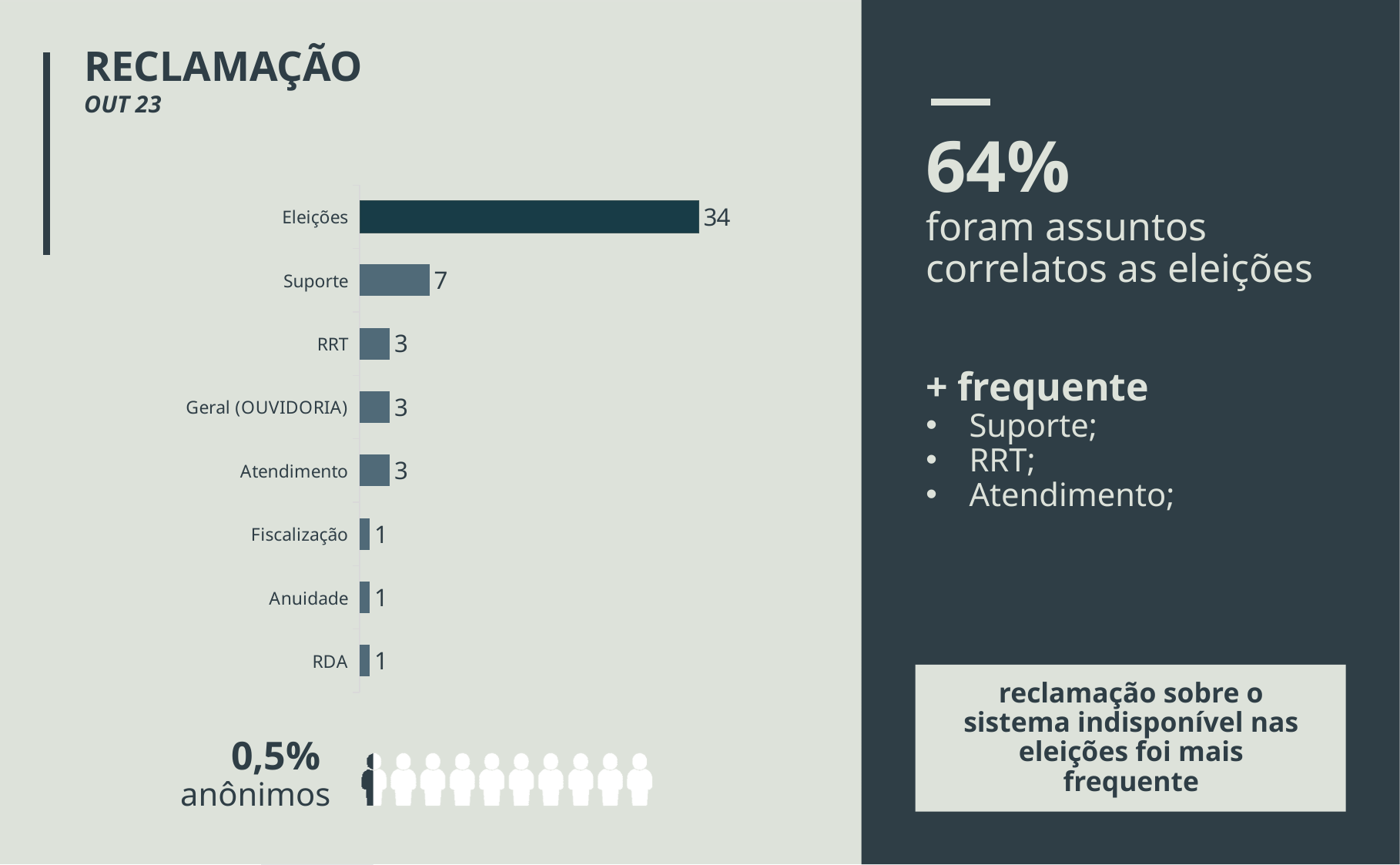
How many categories are shown in the chart? 8 How many categories have a value of 1? 3 What is the difference between the values for Suporte and RRT? 4 What is the title of the slide containing the chart? RECLAMAÇÃO What is the value for Fiscalização? 1 Which category has the highest value? Eleições What is the value for Suporte? 7 What is the value for Eleições? 34 What is the difference between the values for Eleições and Suporte? 27 What kind of chart is shown on the slide? Bar chart Which is larger, the value for Suporte or the value for Atendimento? Suporte What is the value for Geral (OUVIDORIA)? 3